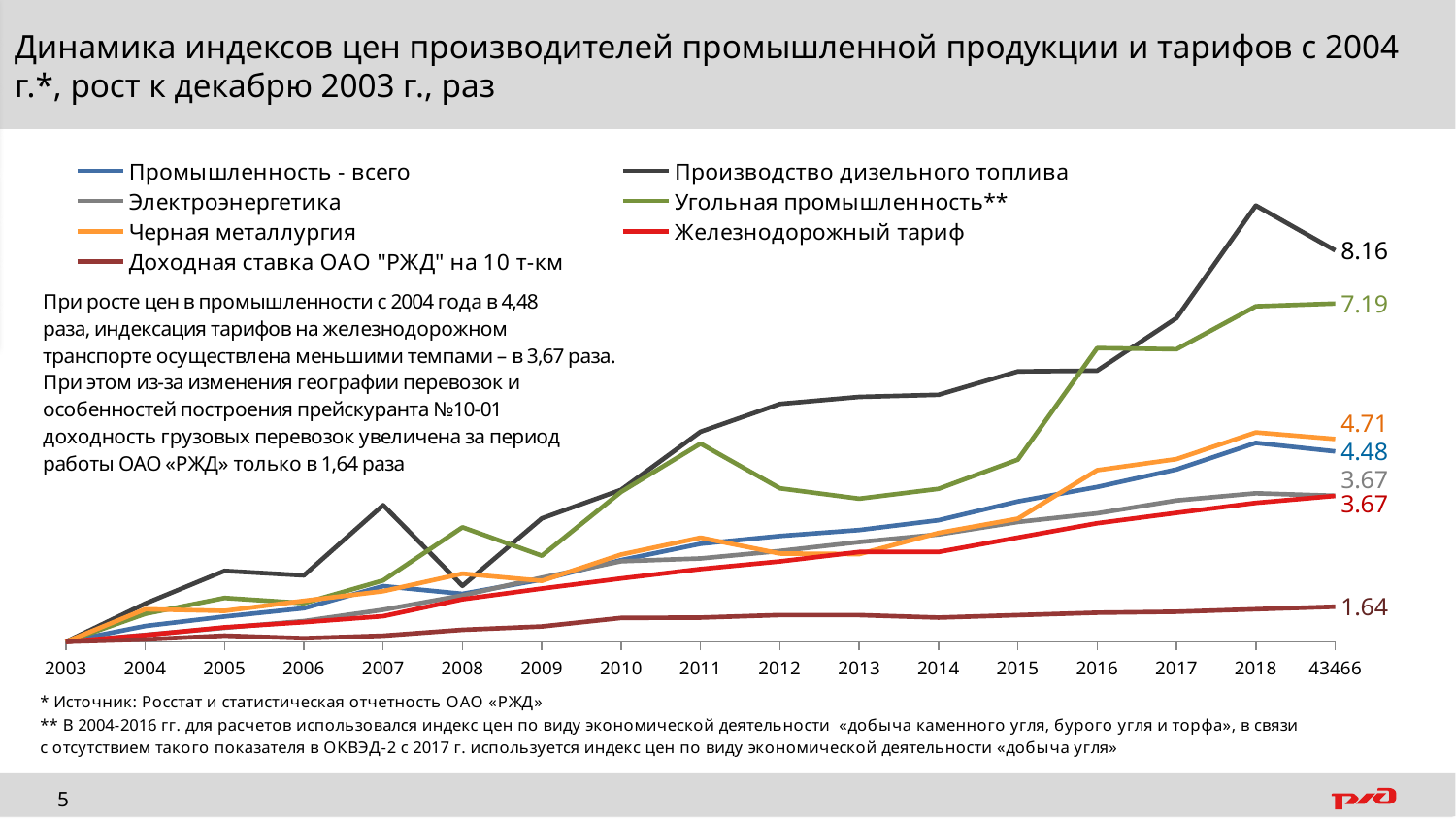
What colour is the line for "Железнодорожный тариф"? red What is the final labelled value for the series "Доходная ставка ОАО "РЖД" на 10 т-км"? 1.64 What is the final labelled value for the series "Черная металлургия"? 4.71 What type of chart is shown on the slide? line chart Which series has the highest final labelled value? Производство дизельного топлива Which series has the lowest final labelled value? Доходная ставка ОАО "РЖД" на 10 т-км What is the final labelled value for the series "Промышленность - всего"? 4.48 How many series does the legend list? 7 What is the final labelled value for the series "Производство дизельного топлива"? 8.16 Which series ends higher, "Черная металлургия" or "Промышленность - всего"? Черная металлургия What is the final labelled value for the series "Угольная промышленность**"? 7.19 What is the difference between the final labelled values of "Производство дизельного топлива" and "Угольная промышленность**"? 0.97